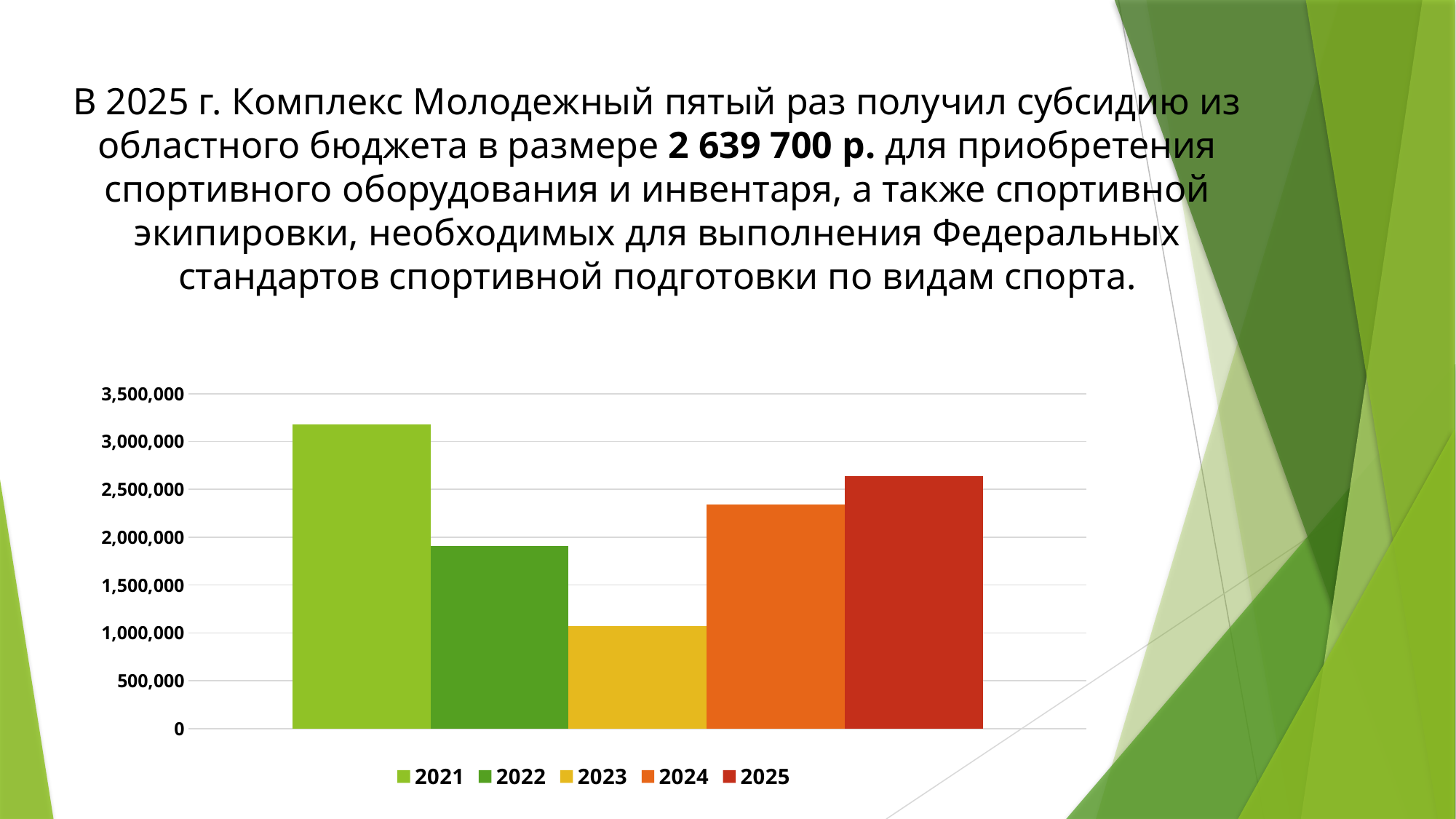
Which year has the lowest bar in the chart? 2023 Is the value for 2025 greater or less than 2,500,000? greater What colour is the bar for 2023 in the chart? yellow Is the value for 2024 greater or less than 2,500,000? less Is the value for 2021 greater or less than 3,000,000? greater Which is larger, the value for 2024 or the value for 2025? 2025 How many series does the legend list? 5 What kind of chart is shown on the slide? bar chart How many bars are plotted in the chart? 5 Which year has the highest bar in the chart? 2021